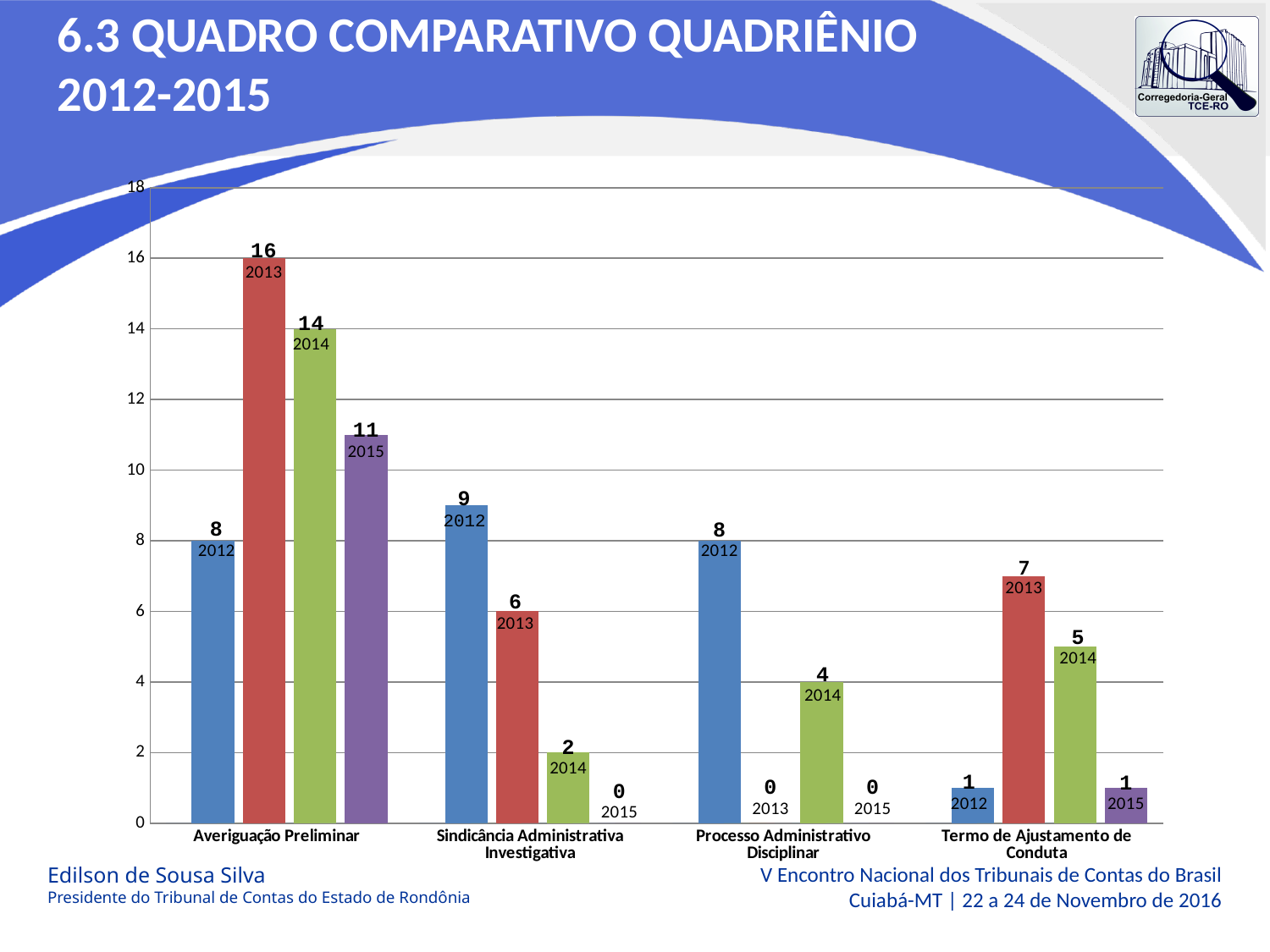
What is the title of the slide containing the chart? 6.3 QUADRO COMPARATIVO QUADRIÊNIO 2012-2015 Do the values for Sindicância Administrativa Investigativa rise or fall from 2012 to 2015? Fall How many categories are shown on the x axis? 4 Which year has the lowest value for Termo de Ajustamento de Conduta? 2012 and 2015 What is the value for Sindicância Administrativa Investigativa in 2012? 9 What is the value for Averiguação Preliminar in 2013? 16 What kind of chart is shown on the slide? Bar chart What is the difference between the 2013 and 2015 values for Averiguação Preliminar? 5 Which is larger: the 2012 value for Sindicância Administrativa Investigativa or the 2012 value for Processo Administrativo Disciplinar? Sindicância Administrativa Investigativa Which year has the highest value for Averiguação Preliminar? 2013 What is the value for Processo Administrativo Disciplinar in 2014? 4 What is the value for Termo de Ajustamento de Conduta in 2015? 1